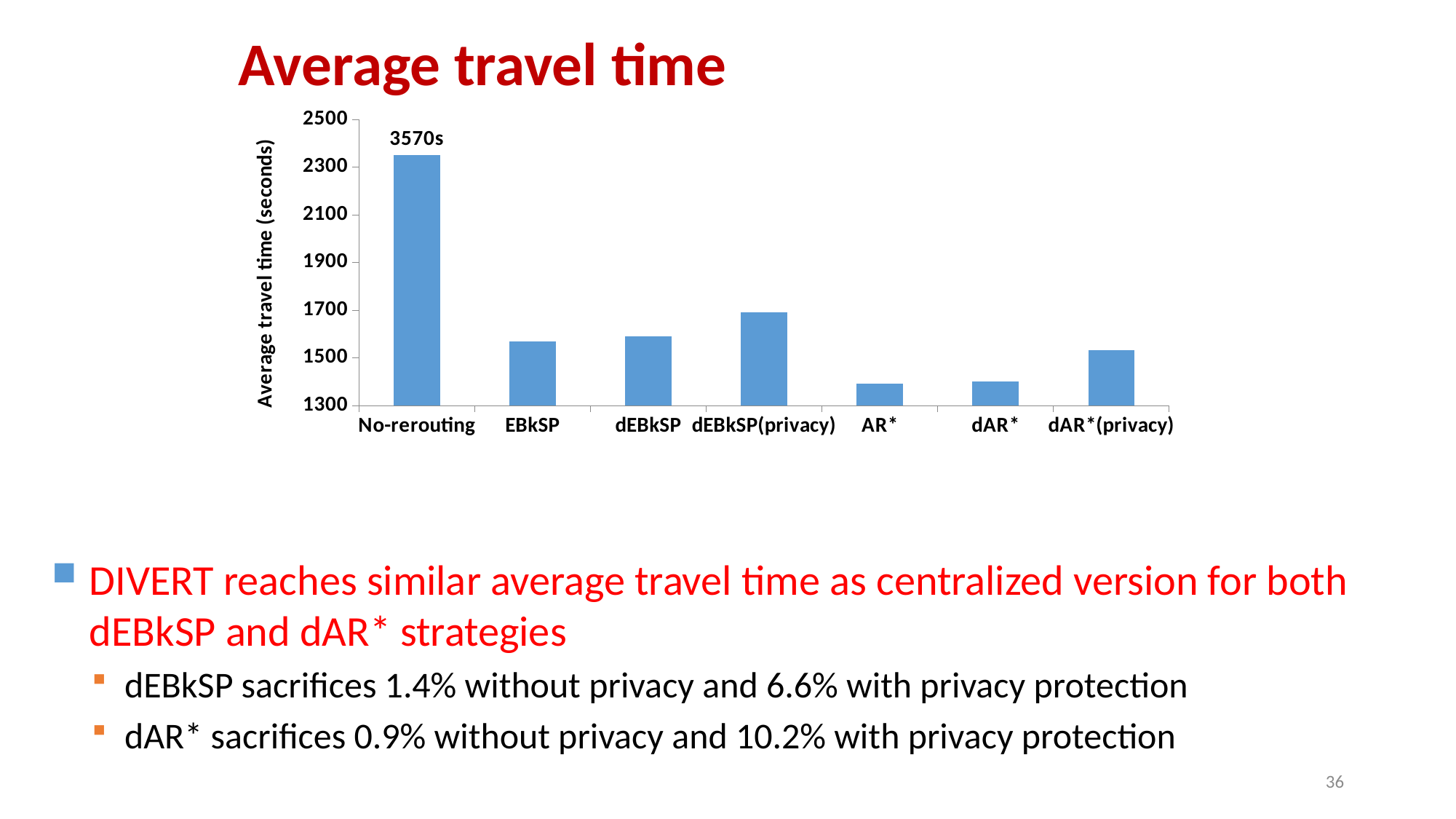
Which has a higher average travel time, dAR* or dAR*(privacy)? dAR*(privacy) How many strategies (bars) are shown in the chart? 7 Is the value for dAR*(privacy) greater or less than 1700? less Is the value for EBkSP greater or less than 1500? greater Is the value for AR* greater or less than 1500? less Which has a higher average travel time, EBkSP or AR*? EBkSP What is the label of the vertical axis of the chart? Average travel time (seconds) What kind of chart is shown on the slide? Bar chart Which strategy has the highest average travel time? No-rerouting What is the average travel time shown for No-rerouting? 3570s Which has a higher average travel time, dEBkSP or dEBkSP(privacy)? dEBkSP(privacy)